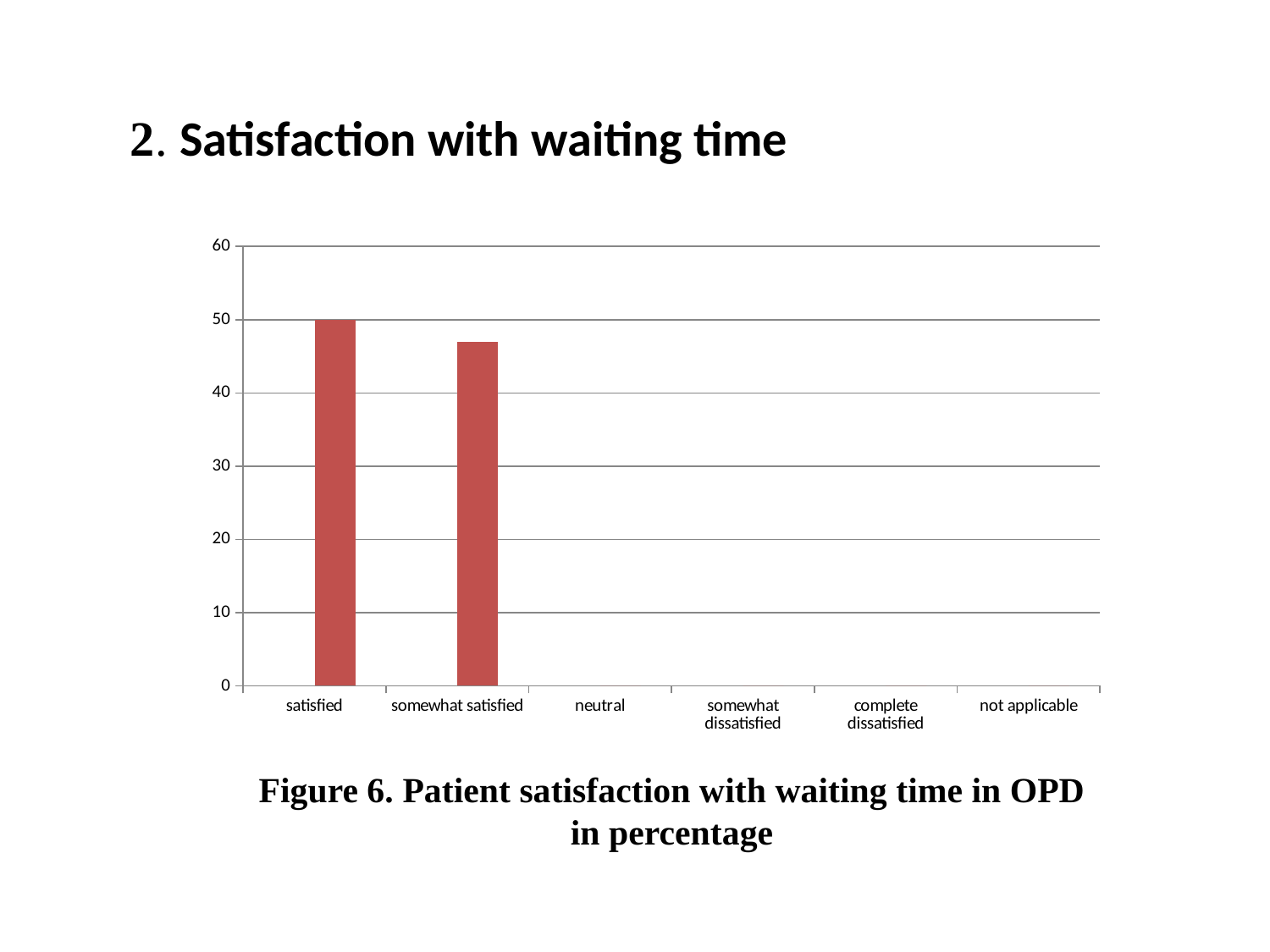
What kind of chart is shown on the slide? bar chart Is the value for somewhat satisfied greater or less than 50? less Is the value for neutral greater or less than 10? less How many categories are shown on the x axis? 6 Do the values generally rise or fall moving from left to right along the x axis? fall What is the highest value shown on the vertical axis? 60 Which is larger, the value for satisfied or the value for somewhat satisfied? satisfied What is the figure caption below the chart? Figure 6. Patient satisfaction with waiting time in OPD in percentage Which category has the highest value? satisfied Is the value for somewhat satisfied greater or less than 40? greater What is the value for the satisfied category? 50